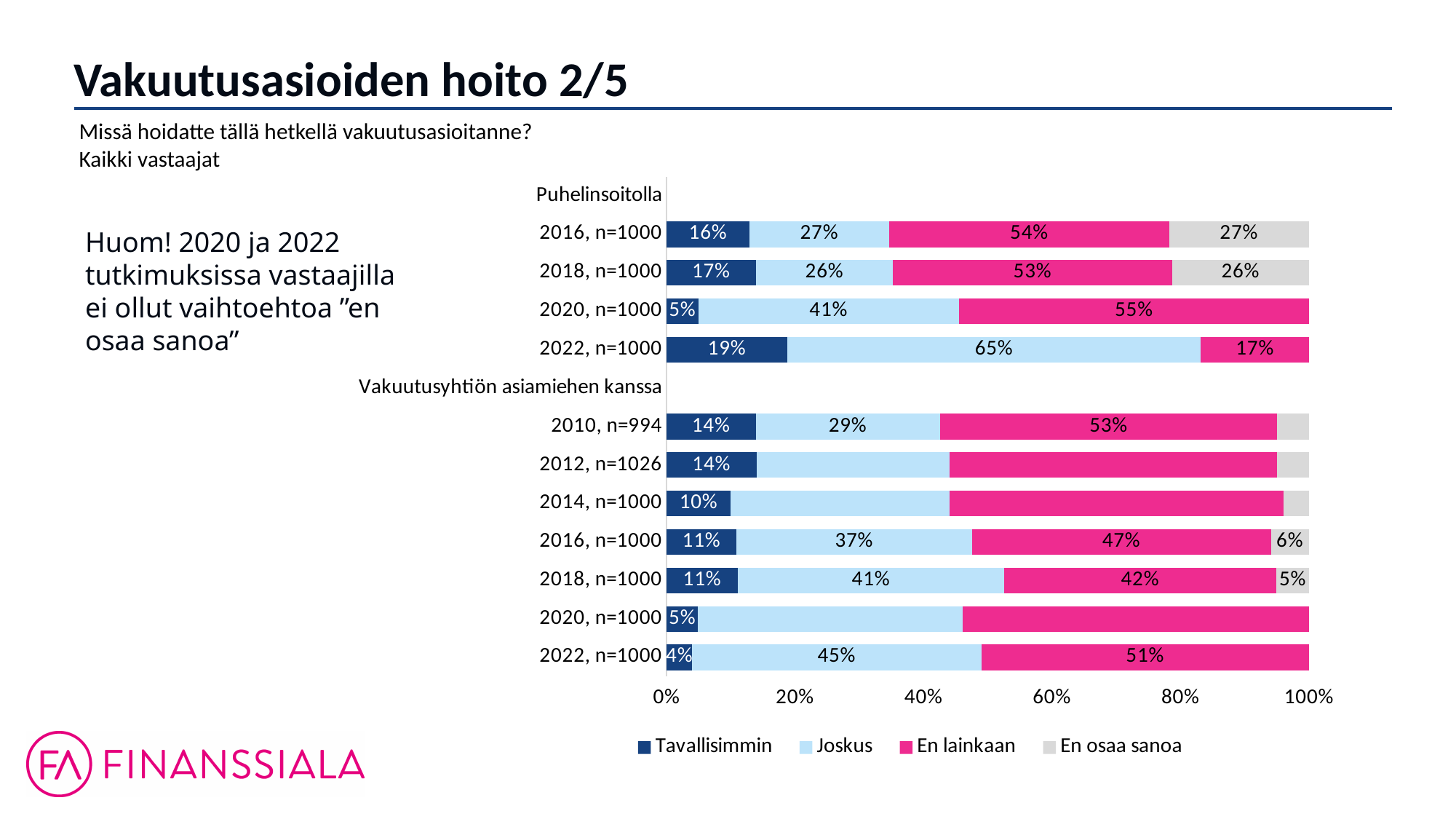
What is the Joskus value for Puhelinsoitolla in 2020, n=1000? 41% What is the En osaa sanoa value for Vakuutusyhtiön asiamiehen kanssa in 2016, n=1000? 6% How much higher is the Joskus value for Puhelinsoitolla in 2022 than in 2020? 24 percentage points How many bars are shown under Vakuutusyhtiön asiamiehen kanssa? 7 What kind of chart is shown on the slide? Stacked bar chart How many series does the legend list? 4 What is the Tavallisimmin value for Puhelinsoitolla in 2022, n=1000? 19% Among the Puhelinsoitolla bars, which year has the highest Tavallisimmin value? 2022, n=1000 Among the Vakuutusyhtiön asiamiehen kanssa bars, which year has the lowest Tavallisimmin value? 2022, n=1000 Is the En lainkaan value for Vakuutusyhtiön asiamiehen kanssa in 2012, n=1026 greater or less than 40%? greater What is the En lainkaan value for Vakuutusyhtiön asiamiehen kanssa in 2022, n=1000? 51% Which is larger: the En lainkaan value for Puhelinsoitolla 2016 or for Vakuutusyhtiön asiamiehen kanssa 2016? Puhelinsoitolla 2016